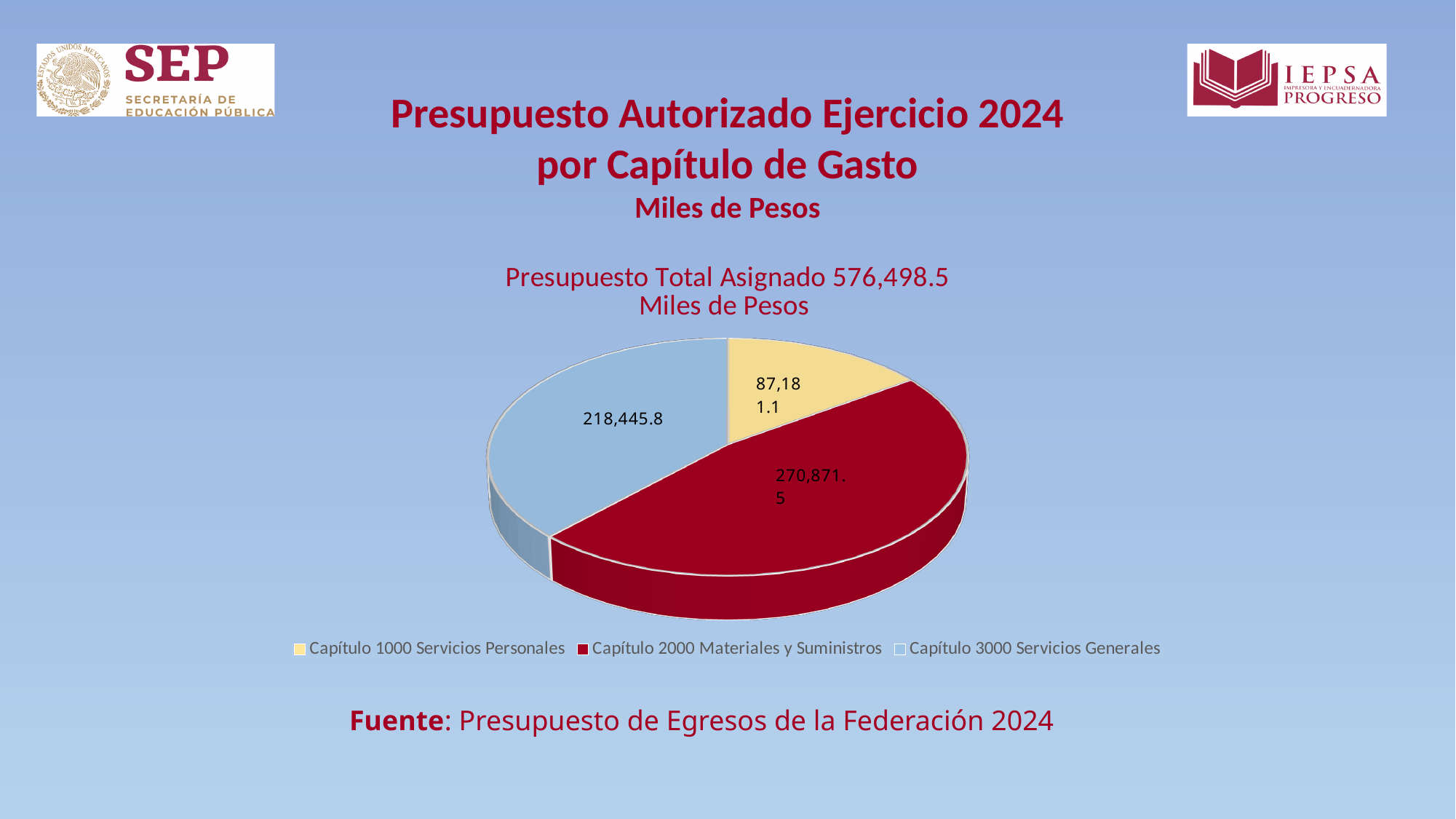
How many categories does the pie chart show? 3 What is the value for Capítulo 1000 Servicios Personales? 87,181.1 What colour is the slice for Capítulo 2000 Materiales y Suministros? red What is the value for Capítulo 2000 Materiales y Suministros? 270,871.5 What is the difference between the values for Capítulo 3000 Servicios Generales and Capítulo 1000 Servicios Personales? 131,264.7 What kind of chart is shown on the slide? pie chart What is the difference between the values for Capítulo 2000 Materiales y Suministros and Capítulo 3000 Servicios Generales? 52,425.7 Which is larger, the value for Capítulo 3000 Servicios Generales or Capítulo 1000 Servicios Personales? Capítulo 3000 Servicios Generales What total budget (Presupuesto Total Asignado) does the chart title state? 576,498.5 What is the value for Capítulo 3000 Servicios Generales? 218,445.8 Which category has the smallest slice of the pie? Capítulo 1000 Servicios Personales Which category has the largest slice of the pie? Capítulo 2000 Materiales y Suministros